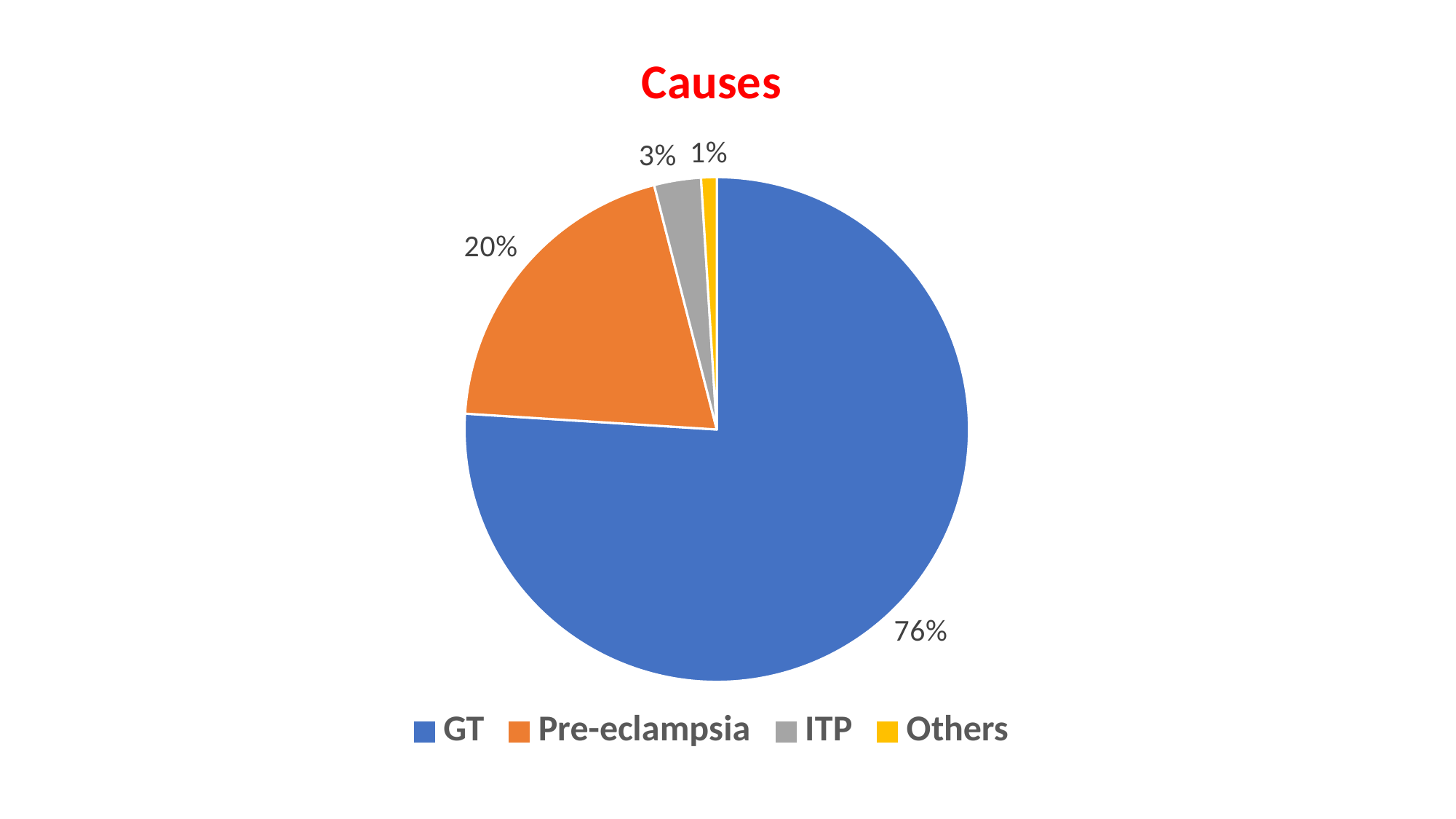
Which category has the smallest share of the pie? Others What percentage of the pie does Pre-eclampsia account for? 20% What percentage of the pie does GT account for? 76% Which is larger, the share for ITP or the share for Others? ITP What is the difference in percentage points between GT and Pre-eclampsia? 56 What colour is the slice for Pre-eclampsia? orange What is the title of the chart? Causes What kind of chart is shown on the slide? pie chart What percentage of the pie does Others account for? 1% How many categories does the legend list? 4 Which category has the largest share of the pie? GT What percentage of the pie does ITP account for? 3%